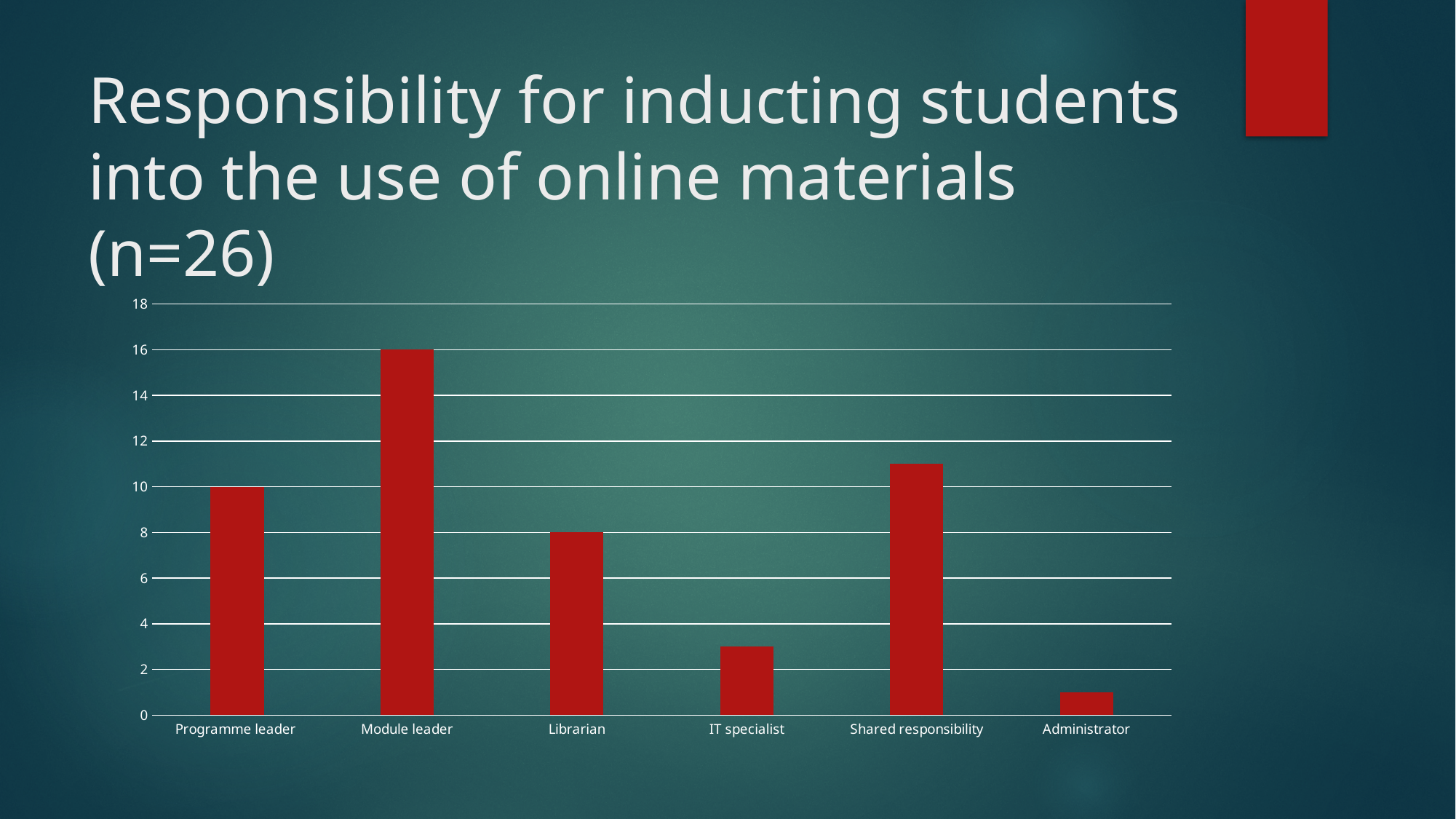
Which is larger, the value for Shared responsibility or the value for Librarian? Shared responsibility Is the value for Shared responsibility greater or less than 10? greater What is the difference between the values for Module leader and Librarian? 8 What is the value for Librarian? 8 How many categories are shown on the x axis? 6 Which category has the highest value? Module leader What is the value for Programme leader? 10 What is the difference between the values for Module leader and Programme leader? 6 What kind of chart is shown on the slide? bar chart Which category has the lowest value? Administrator Is the value for IT specialist greater or less than 4? less What is the value for Module leader? 16